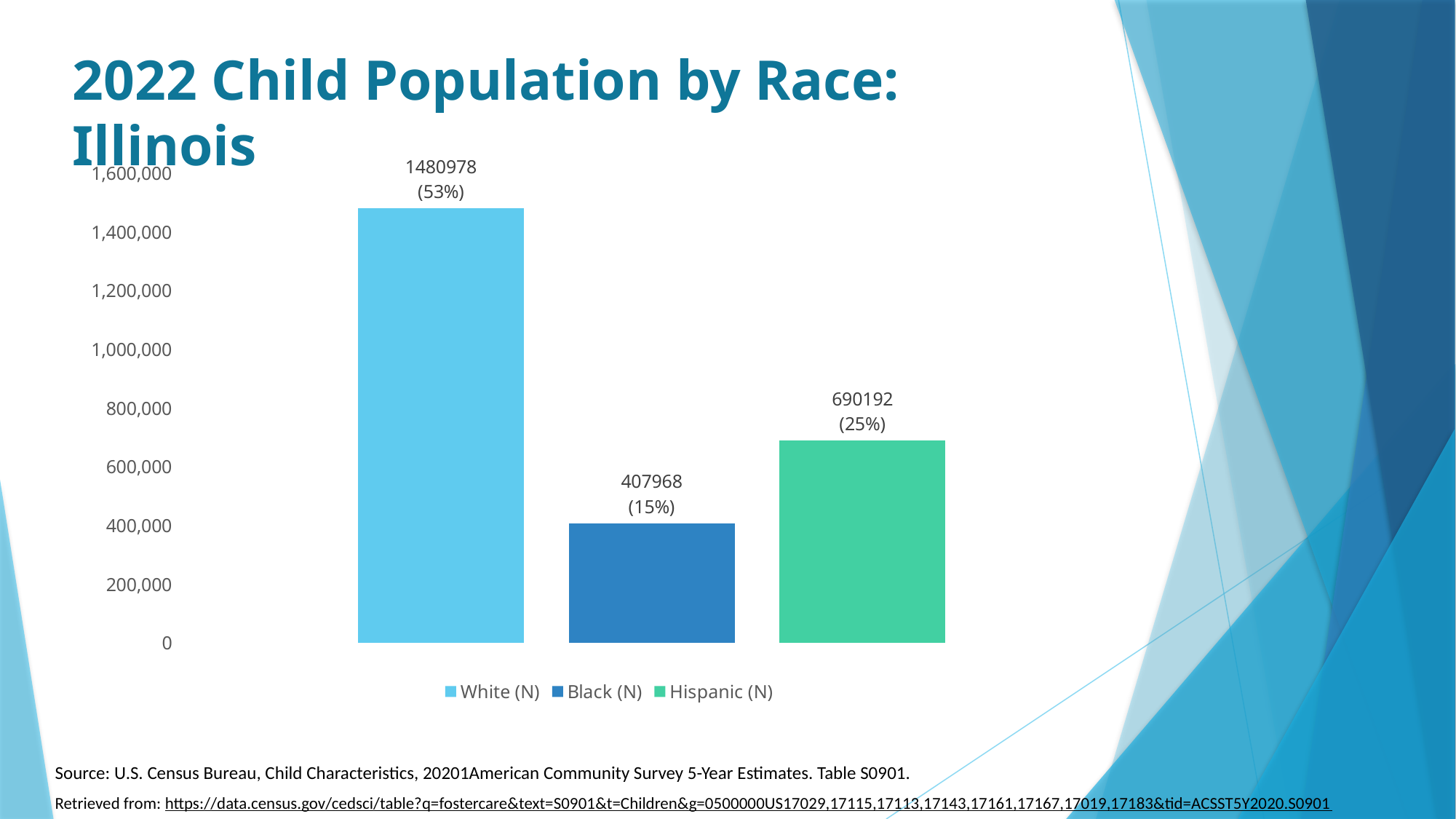
How many bars are plotted in the chart? 3 What percentage is shown for Hispanic (N)? 25% What is the difference between the values for Hispanic (N) and Black (N)? 282224 Which is larger, the value for Hispanic (N) or the value for Black (N)? Hispanic (N) How many entries does the legend list? 3 What is the value shown for Black (N)? 407968 Which group has the highest child population? White (N) Which group has the lowest child population? Black (N) What kind of chart is shown on the slide? Bar chart Is the value for White (N) greater or less than 1,400,000? greater What is the value shown for White (N)? 1480978 What is the difference between the values for White (N) and Hispanic (N)? 790786